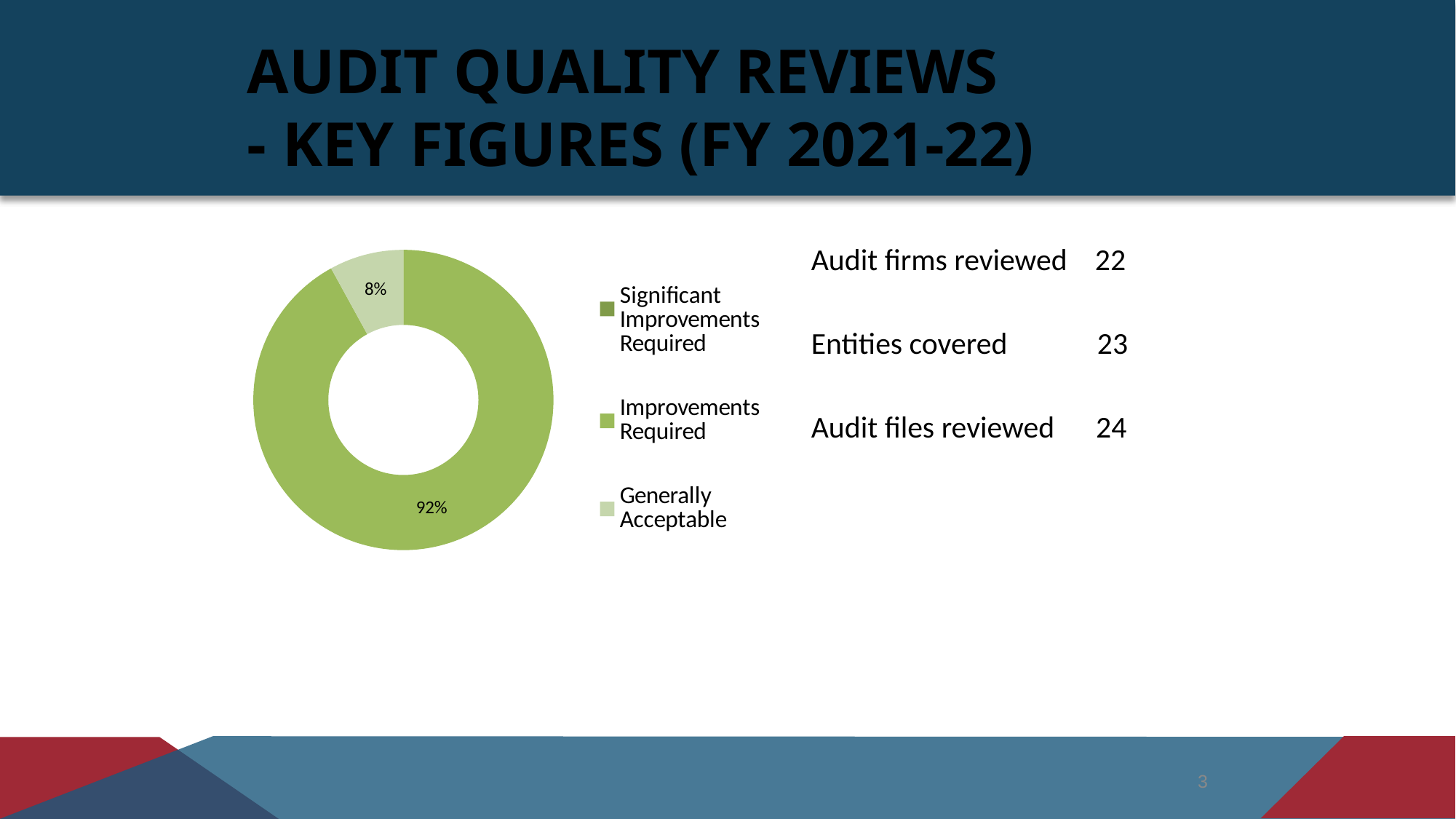
What share of the doughnut chart is labelled for Improvements Required? 92% What is the difference in percentage points between the 92% slice and the 8% slice? 84 percentage points What is the title of the slide containing the chart? AUDIT QUALITY REVIEWS - KEY FIGURES (FY 2021-22) Which labelled slice in the doughnut chart is the smallest? Generally Acceptable How many entries does the legend of the doughnut chart list? 3 Is the share for Improvements Required greater or less than 50%? greater What kind of chart is shown on the slide? Doughnut (pie) chart How many slices with data labels are visible in the doughnut chart? 2 Which is larger in the doughnut chart: Improvements Required or Generally Acceptable? Improvements Required Which legend entry is shown with the lightest green colour? Generally Acceptable Which category has the largest slice in the doughnut chart? Improvements Required What share of the doughnut chart is labelled for Generally Acceptable? 8%